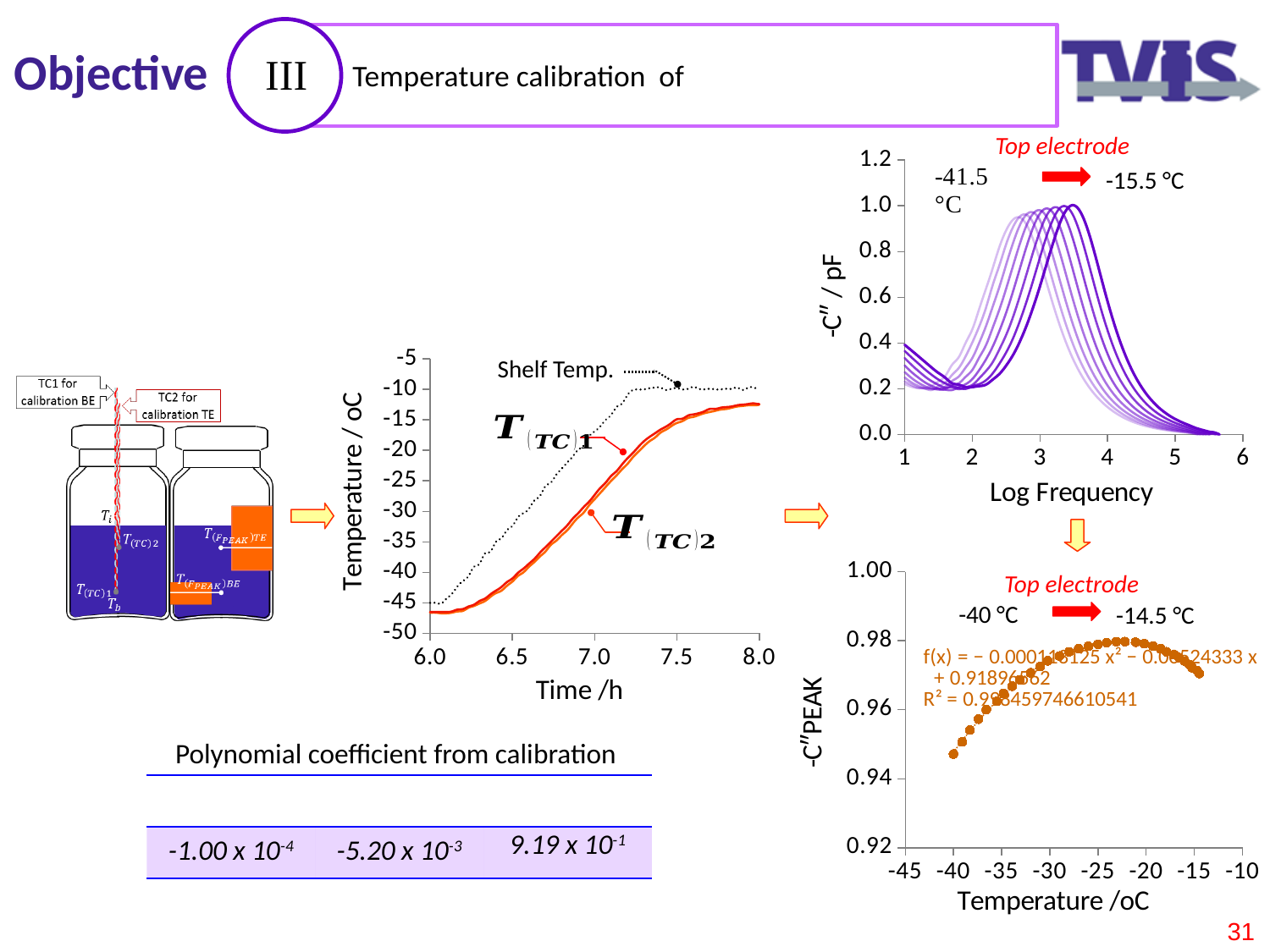
In the chart with Time /h on the x axis, what is the label of the dotted series? Shelf Temp. What kind of chart is the chart with Log Frequency on the x axis? line chart In the chart with Time /h on the x axis, do the temperature curves rise or fall as time increases from 6.0 h to 8.0 h? rise What kind of chart is the chart with -C''PEAK on the y axis? scatter chart What kind of chart is the chart with Time /h on the x axis? line chart In the chart with Log Frequency on the x axis, is the peak value of the curves greater or less than 1.2? less In the chart with Time /h on the x axis, what is the highest value shown on the y axis? -5 In the chart with Time /h on the x axis, is the Shelf Temp. value at 7.5 h greater or less than -15? greater In the chart with Time /h on the x axis, is the T(TC)1 value at 6.0 h greater or less than -40? less In the chart with Log Frequency on the x axis, what temperature range is indicated above the curves? -41.5 °C to -15.5 °C